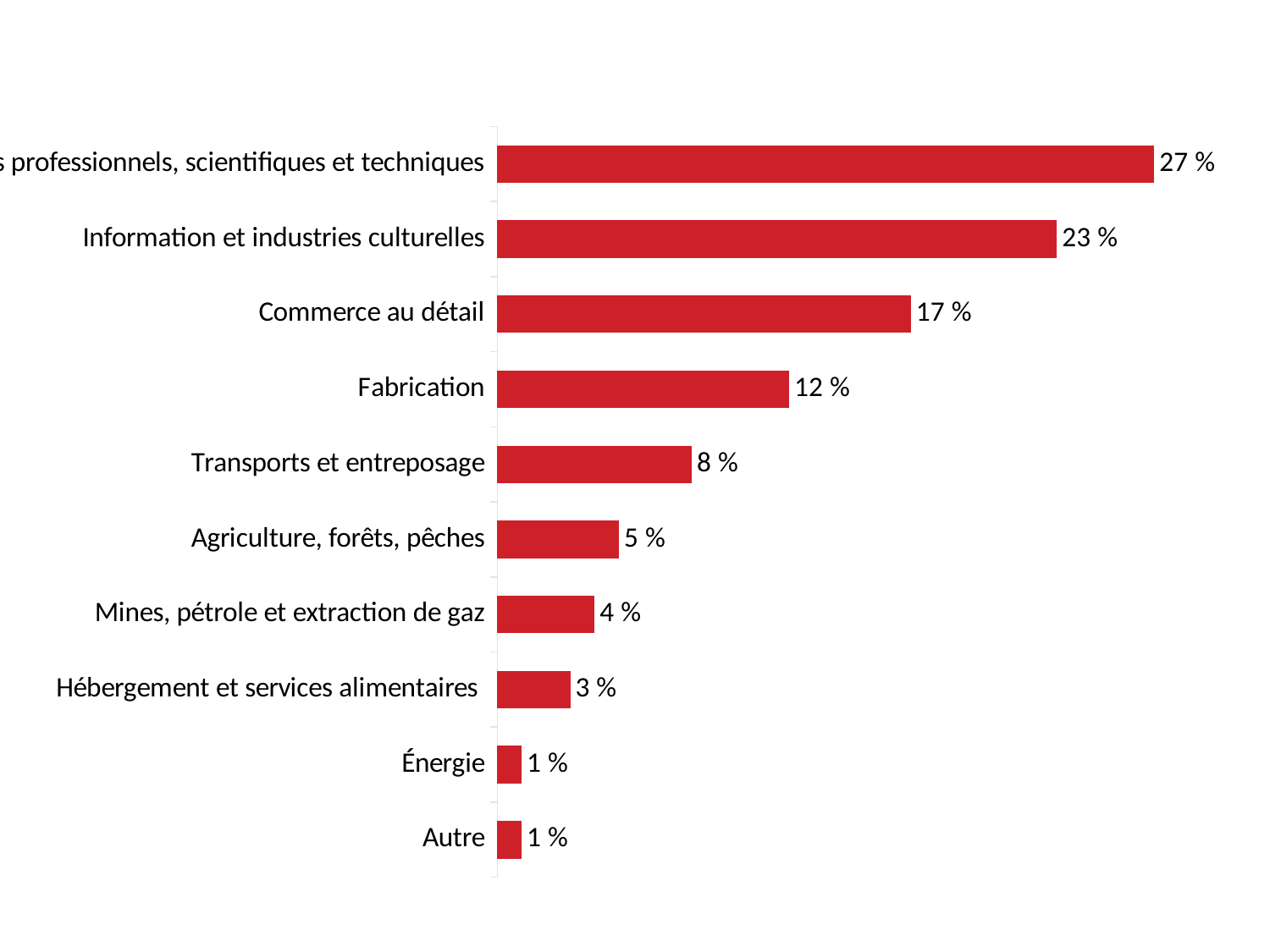
What is the value for Fabrication? 12 % How many categories are shown on the chart? 10 What is the value for Commerce au détail? 17 % What is the value for Transports et entreposage? 8 % What kind of chart is this? Bar chart What is the difference between Fabrication and Transports et entreposage? 4 % What is the highest value shown on the chart? 27 % What is the value for Mines, pétrole et extraction de gaz? 4 % What is the difference between Information et industries culturelles and Commerce au détail? 6 % Which is larger, Agriculture, forêts, pêches or Mines, pétrole et extraction de gaz? Agriculture, forêts, pêches What is the value for Hébergement et services alimentaires? 3 % What is the value for Information et industries culturelles? 23 %